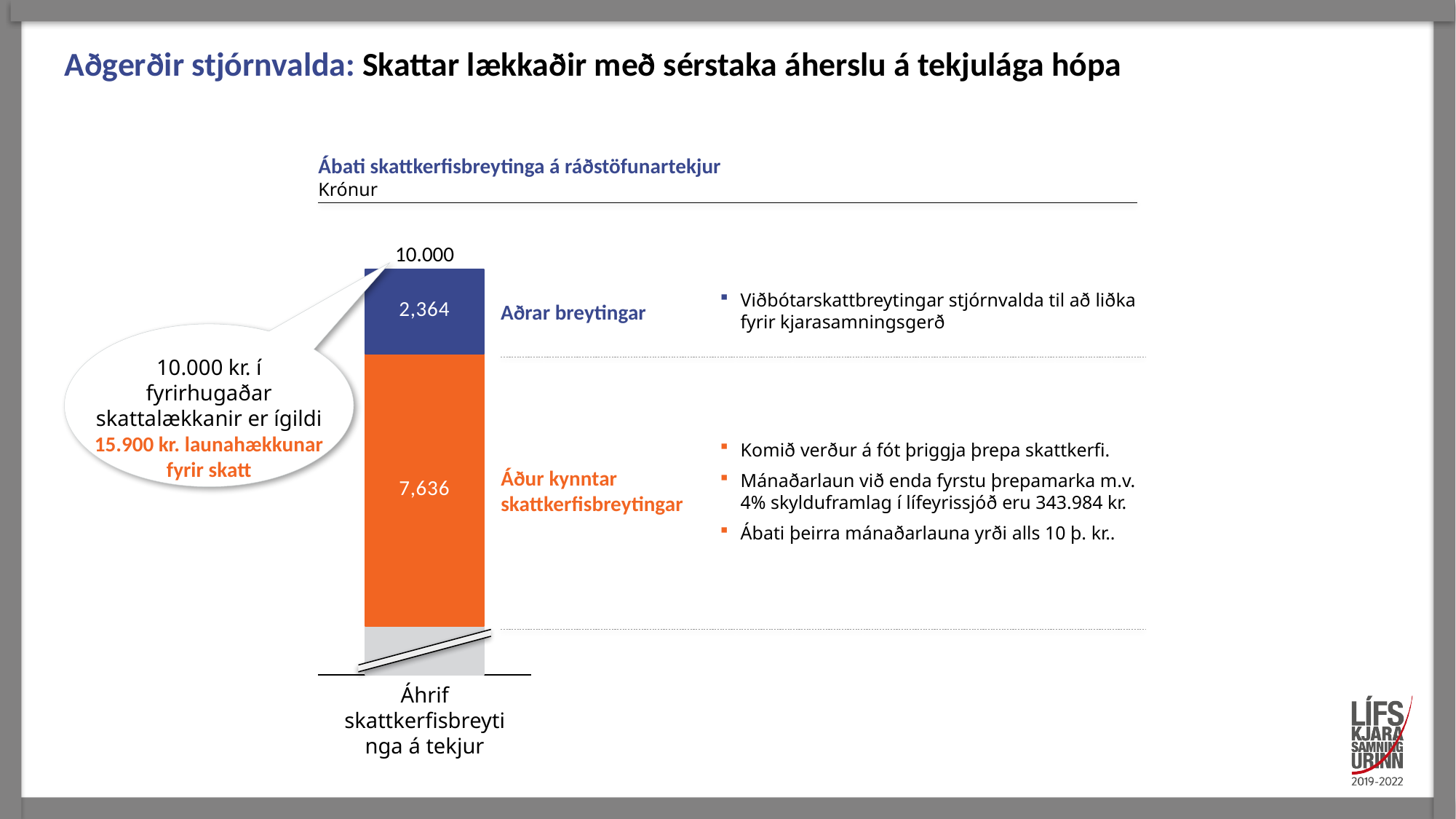
What is the total of the stacked bar, as labelled at its top? 10.000 What is the value of the Áður kynntar skattkerfisbreytingar segment in the stacked bar? 7,636 Which is larger: the Aðrar breytingar segment or the Áður kynntar skattkerfisbreytingar segment? Áður kynntar skattkerfisbreytingar What unit is stated under the chart title? Krónur How many bars are plotted in the chart? 1 What is the title of the chart? Ábati skattkerfisbreytinga á ráðstöfunartekjur What is the difference between the Áður kynntar skattkerfisbreytingar segment and the Aðrar breytingar segment? 5,272 Which segment of the stacked bar is the largest? Áður kynntar skattkerfisbreytingar What kind of chart is shown on the slide? Stacked bar chart What is the value of the Aðrar breytingar segment in the stacked bar? 2,364 How many labelled segments make up the stacked bar? 2